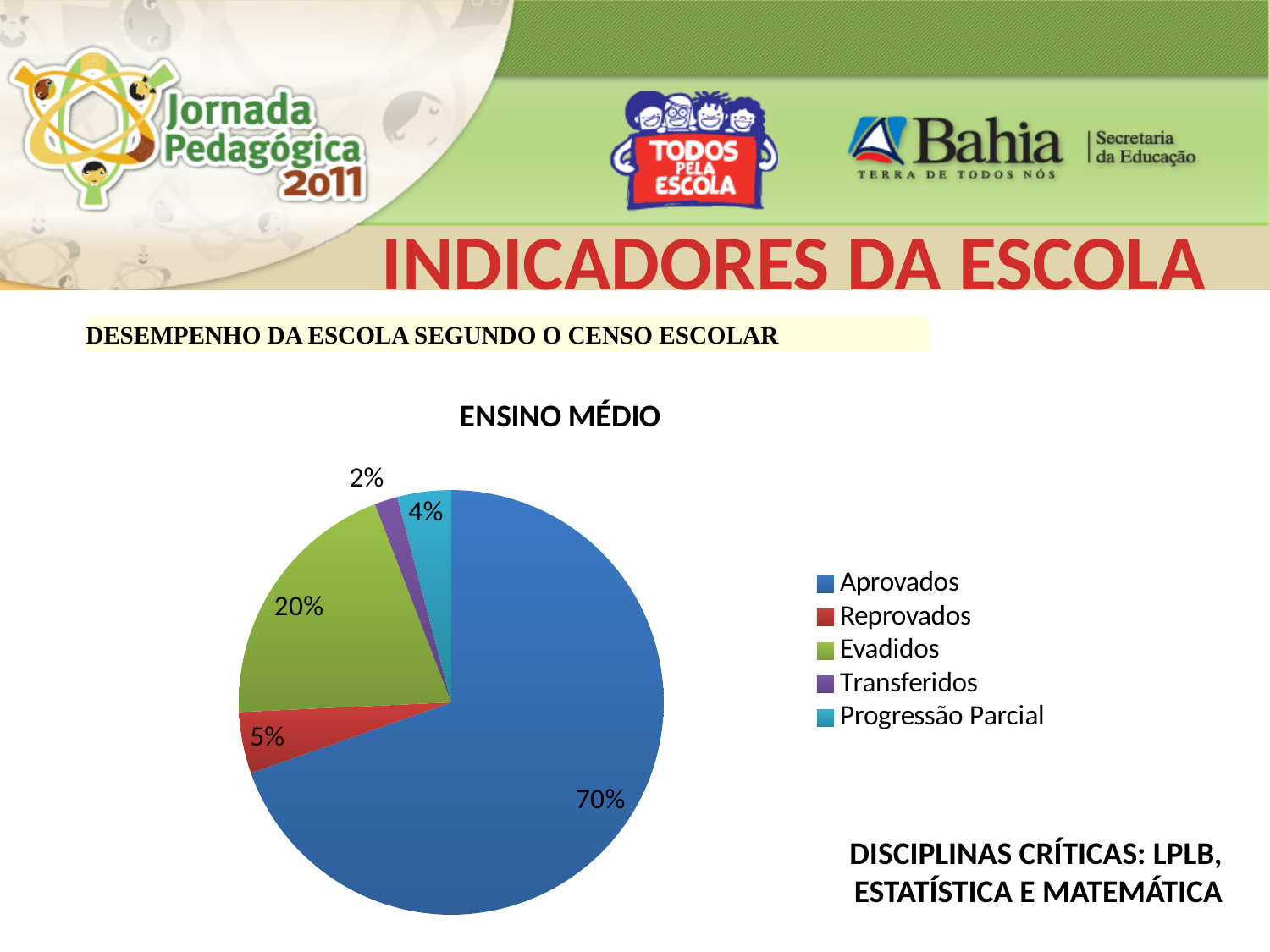
Which category has the largest share of the pie? Aprovados Which category has the smallest share of the pie? Transferidos What percentage of the pie is Transferidos? 2% How many categories does the legend list? 5 What kind of chart is shown on the slide? pie chart What is the title of the chart? ENSINO MÉDIO Which is larger, the share for Reprovados or the share for Progressão Parcial? Reprovados What percentage of the pie is Aprovados? 70% What is the difference in percentage points between Aprovados and Evadidos? 50 What percentage of the pie is Progressão Parcial? 4% What percentage of the pie is Reprovados? 5% What percentage of the pie is Evadidos? 20%